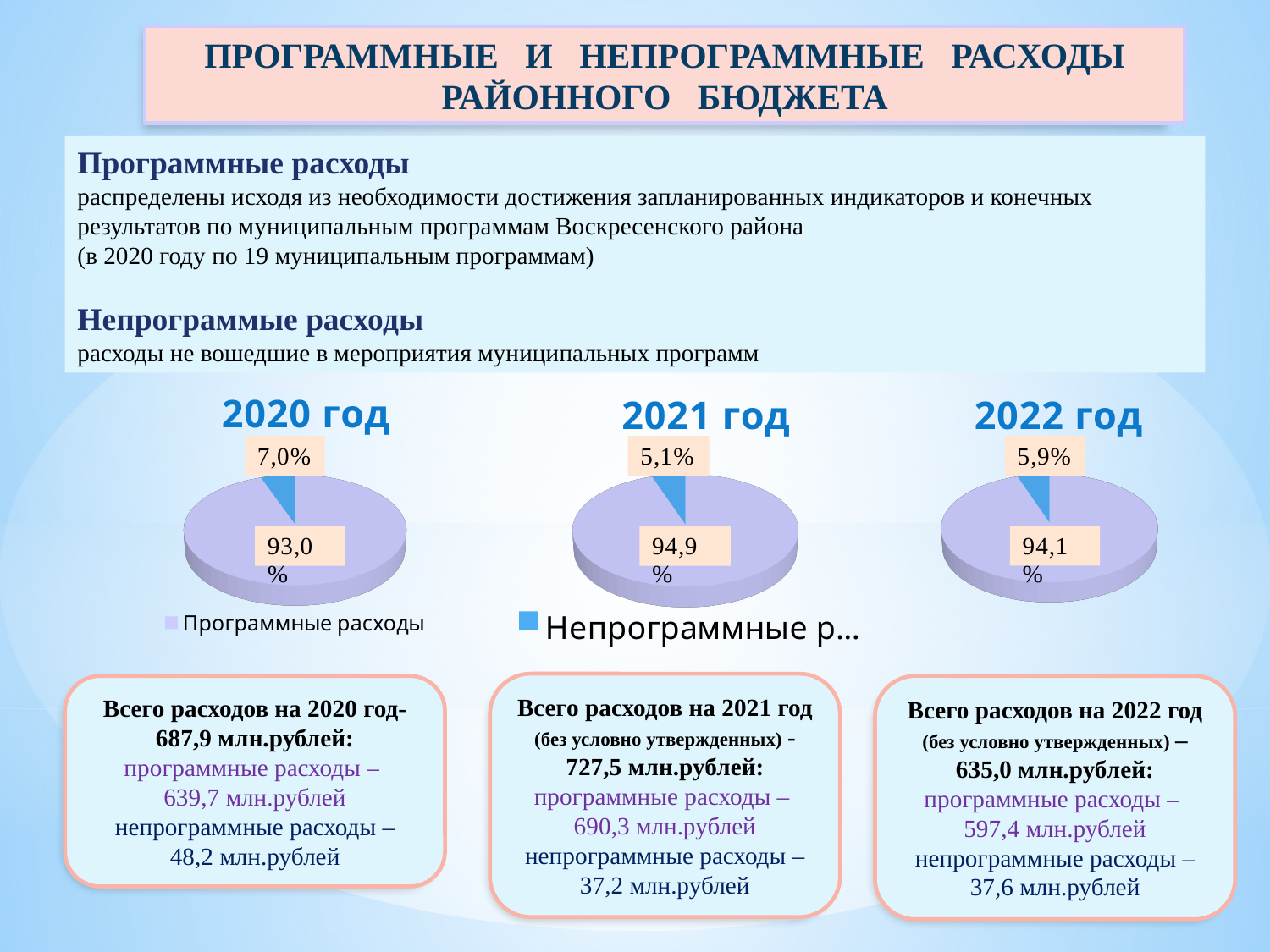
In the 2021 год pie chart, what share is shown for Непрограммные расходы? 5,1% In the 2022 год pie chart, which slice is the largest? Программные расходы In the 2022 год pie chart, what share is shown for Непрограммные расходы? 5,9% What kind of chart is used for the 2020 год chart? pie chart How many slices does the 2020 год pie chart have? 2 In the 2021 год pie chart, what share is shown for Программные расходы? 94,9% Which is larger: the Непрограммные расходы share in the 2020 год chart or in the 2021 год chart? 2020 год What is the difference between the Программные расходы share in the 2021 год chart and in the 2020 год chart? 1,9% In the 2020 год pie chart, what share is shown for Программные расходы? 93,0% In the 2020 год pie chart, what share is shown for Непрограммные расходы? 7,0% In the 2022 год pie chart, what share is shown for Программные расходы? 94,1% In the 2021 год pie chart, which slice is the smallest? Непрограммные расходы